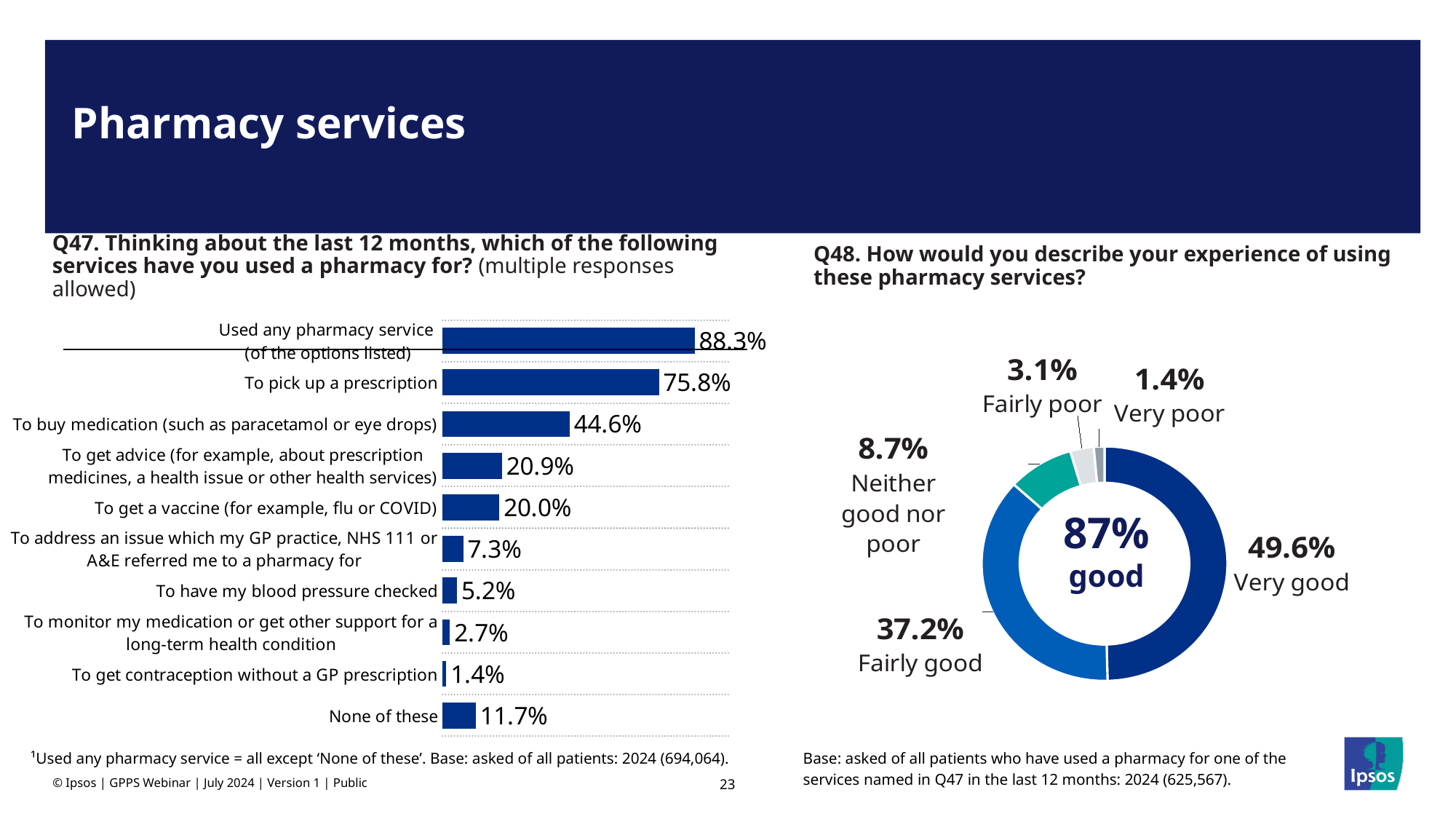
In the Q47 bar chart on the left, which listed service (excluding 'Used any pharmacy service') has the lowest percentage? To get contraception without a GP prescription In the Q47 bar chart on the left, what percentage of patients used a pharmacy to pick up a prescription? 75.8% How many categories (bars) are shown in the Q47 bar chart on the left? 10 What type of chart is used for Q47 on the left of the slide? Bar chart In the Q47 bar chart on the left, what percentage of patients used a pharmacy to get a vaccine (for example, flu or COVID)? 20.0% What type of chart is used for Q48 on the right of the slide? Donut (pie) chart In the Q48 chart on the right, what percentage of patients described their experience as 'Fairly good'? 37.2% In the Q48 chart on the right, what is the combined percentage of 'Fairly poor' and 'Very poor' responses? 4.5% In the Q48 chart on the right, which response category has the largest share? Very good In the Q47 bar chart on the left, which is larger: the percentage who used a pharmacy to get advice or the percentage who used it to get a vaccine? To get advice In the Q47 bar chart on the left, what is the difference between the percentage who used a pharmacy to pick up a prescription and the percentage who used it to buy medication? 31.2% In the Q47 bar chart on the left, what percentage of patients selected 'None of these'? 11.7%